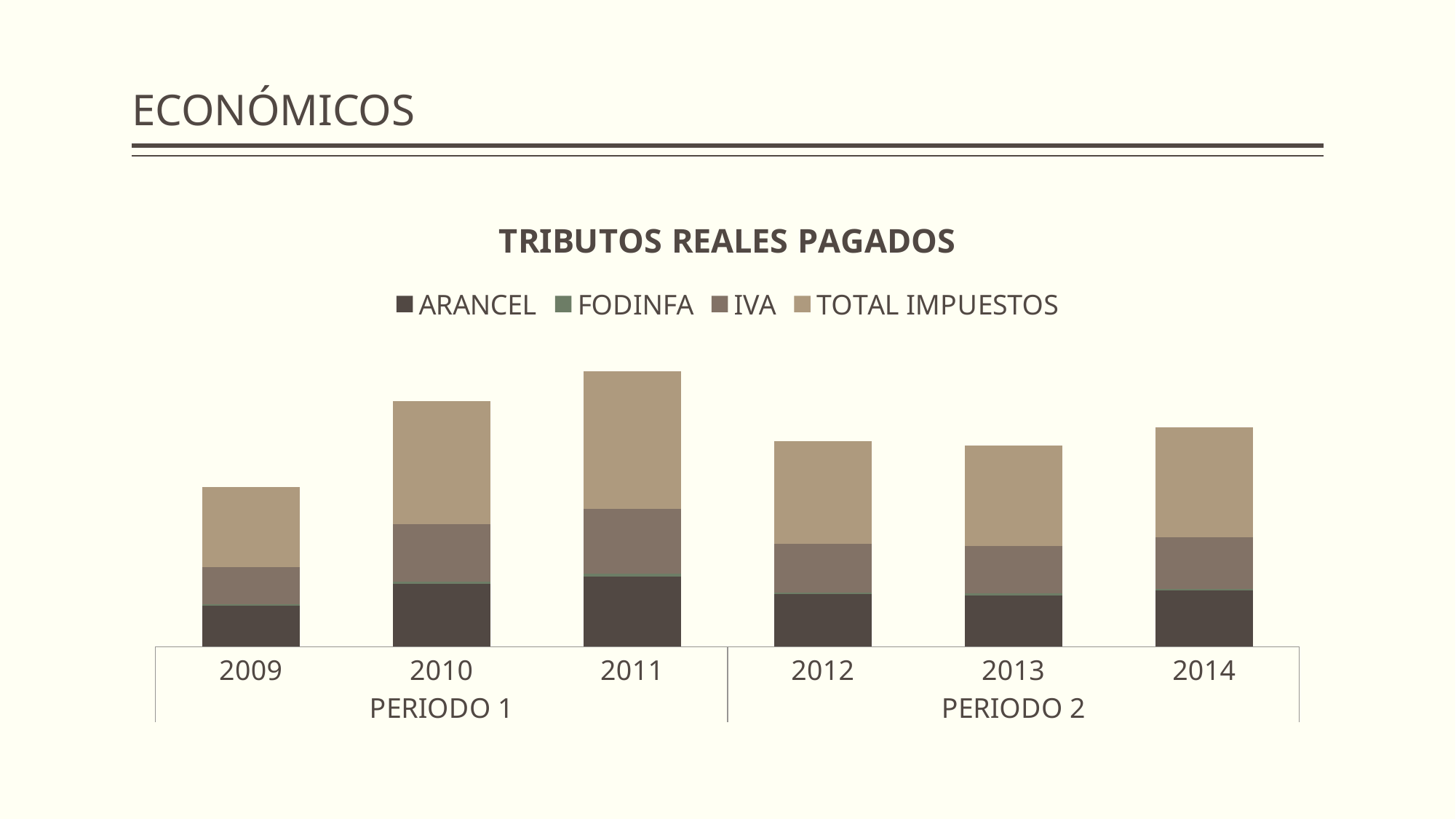
Which year has the smallest ARANCEL segment? 2009 Which stacked bar is taller, 2010 or 2011? 2011 Which year has the tallest stacked bar? 2011 Which stacked bar is taller, 2010 or 2012? 2010 What kind of chart is shown on the slide? Stacked bar chart How many series does the legend list? 4 Do the stacked bars rise or fall from 2009 to 2011 within PERIODO 1? Rise What is the title of the chart? TRIBUTOS REALES PAGADOS Which series are listed in the legend? ARANCEL, FODINFA, IVA, TOTAL IMPUESTOS Which year has the shortest stacked bar? 2009 How many years (bars) are plotted on the x axis? 6 Which years belong to the group labelled PERIODO 2? 2012, 2013, 2014